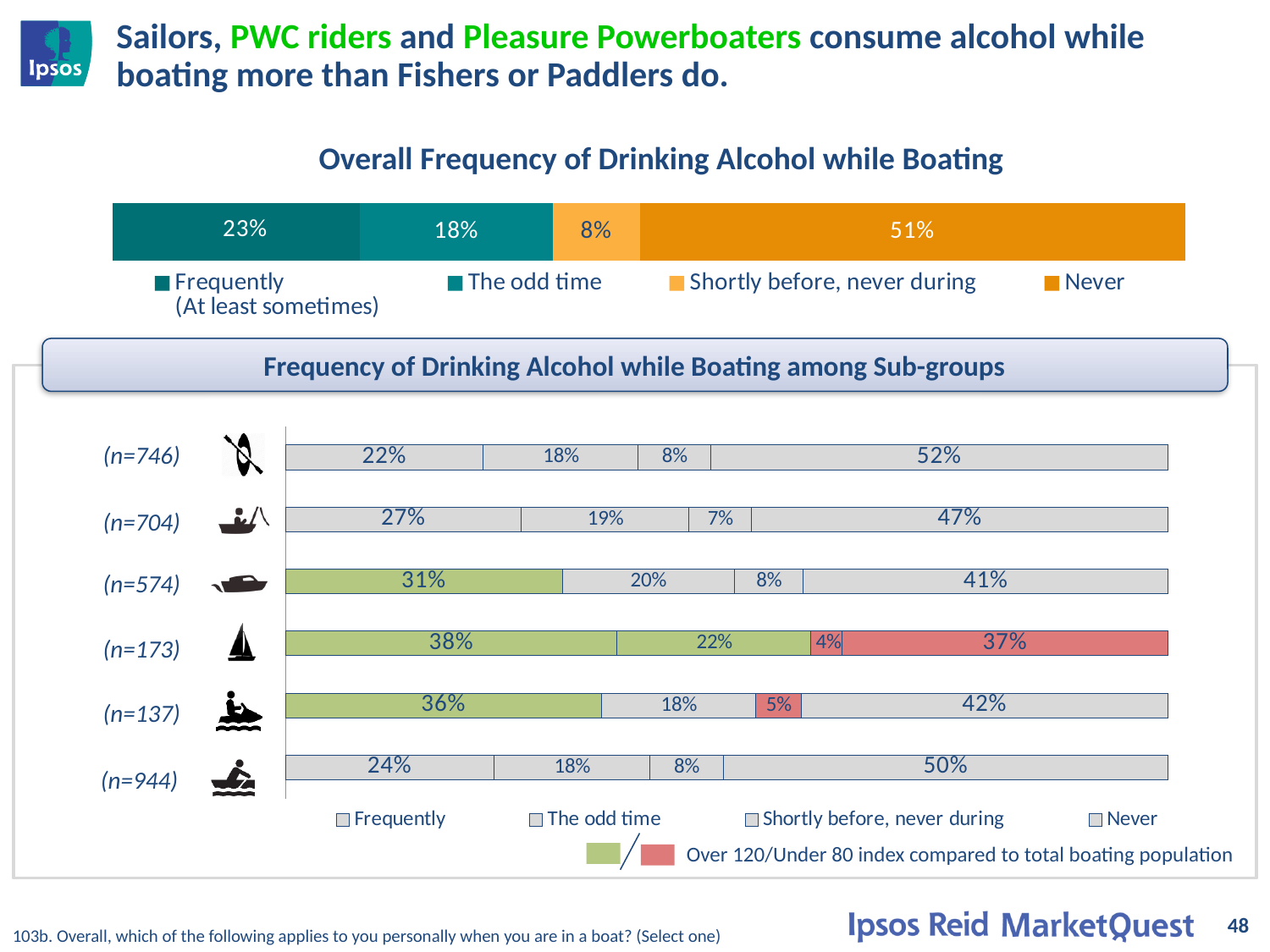
In the Frequency of Drinking Alcohol while Boating among Sub-groups chart, how many sub-group rows are plotted? 6 In the Frequency of Drinking Alcohol while Boating among Sub-groups chart, what is the Never percentage for the (n=746) row? 52% What type of chart is used for the Frequency of Drinking Alcohol while Boating among Sub-groups? Stacked bar chart In the Frequency of Drinking Alcohol while Boating among Sub-groups chart, what is the difference between the Never percentages of the (n=944) row and the (n=173) row? 13 percentage points In the Overall Frequency of Drinking Alcohol while Boating chart, what percentage is shown for Frequently (At least sometimes)? 23% In the Frequency of Drinking Alcohol while Boating among Sub-groups chart, is the Frequently percentage larger for the (n=137) row or the (n=574) row? (n=137) In the Frequency of Drinking Alcohol while Boating among Sub-groups chart, what is the Frequently percentage for the (n=173) row? 38% In the Frequency of Drinking Alcohol while Boating among Sub-groups chart, which row has the highest Frequently percentage? (n=173) In the Overall Frequency of Drinking Alcohol while Boating chart, how many segments does the legend list? 4 In the Frequency of Drinking Alcohol while Boating among Sub-groups chart, which row has the lowest Never percentage? (n=173) In the Overall Frequency of Drinking Alcohol while Boating chart, what percentage is shown for Never? 51% In the Overall Frequency of Drinking Alcohol while Boating chart, what is the difference between the Never and The odd time percentages? 33 percentage points